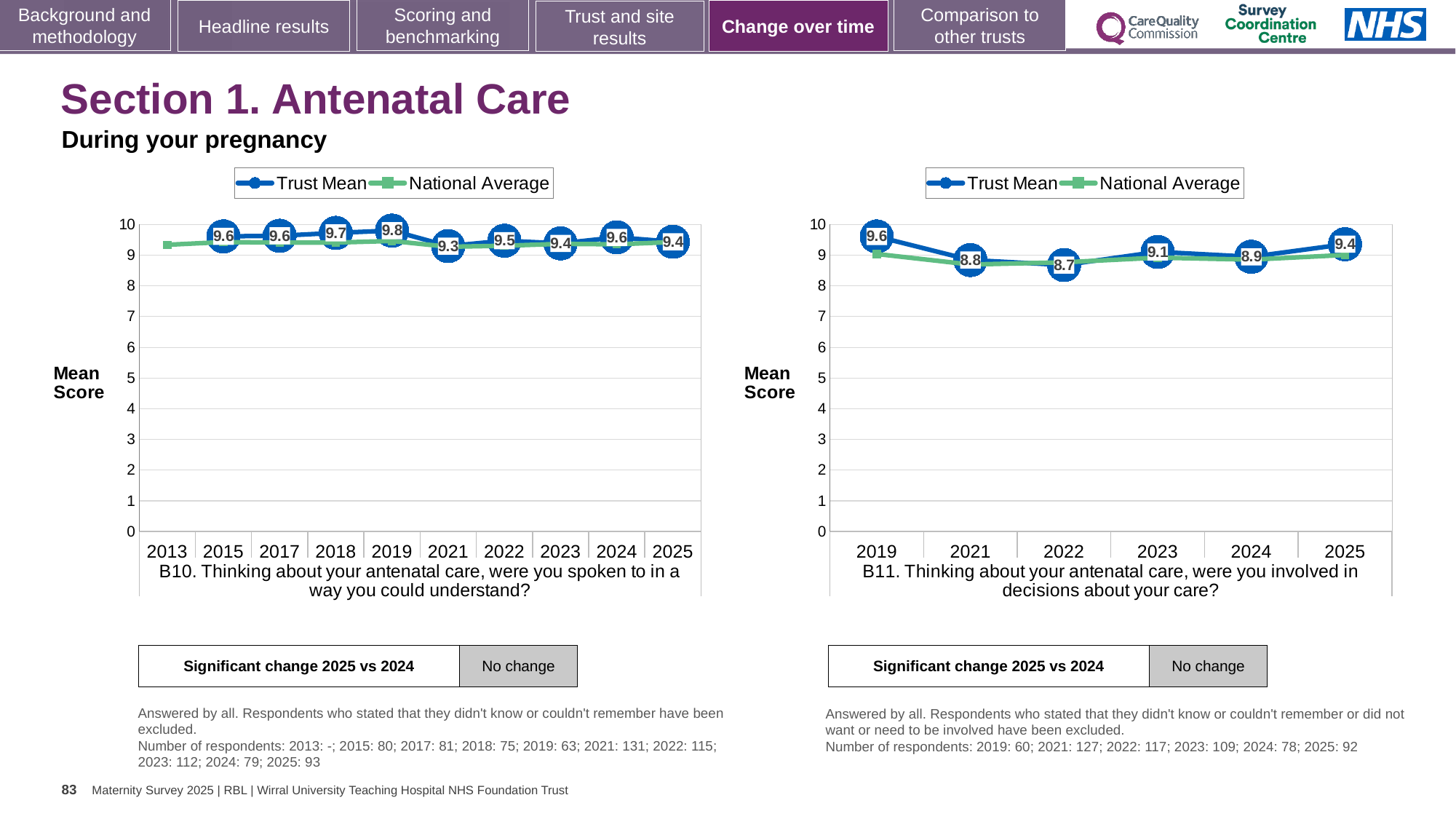
In the B10 chart on the left, what is the Trust Mean for 2025? 9.4 In the B10 chart on the left, what is the Trust Mean for 2019? 9.8 How many series does the legend of the B10 chart on the left list? 2 In the B11 chart on the right, does the Trust Mean rise or fall from 2024 to 2025? Rise In the B10 chart on the left, is the Trust Mean higher in 2019 or in 2021? 2019 In the B11 chart on the right, which year has the lowest Trust Mean? 2022 What kind of chart is the B11 chart on the right? Line chart In the B10 chart on the left, which year has the lowest Trust Mean? 2021 In the B11 chart on the right, which year has the highest Trust Mean? 2019 In the B11 chart on the right, what is the difference between the Trust Mean for 2019 and for 2022? 0.9 How many years are shown on the x axis of the B11 chart on the right? 6 In the B11 chart on the right, what is the Trust Mean for 2022? 8.7